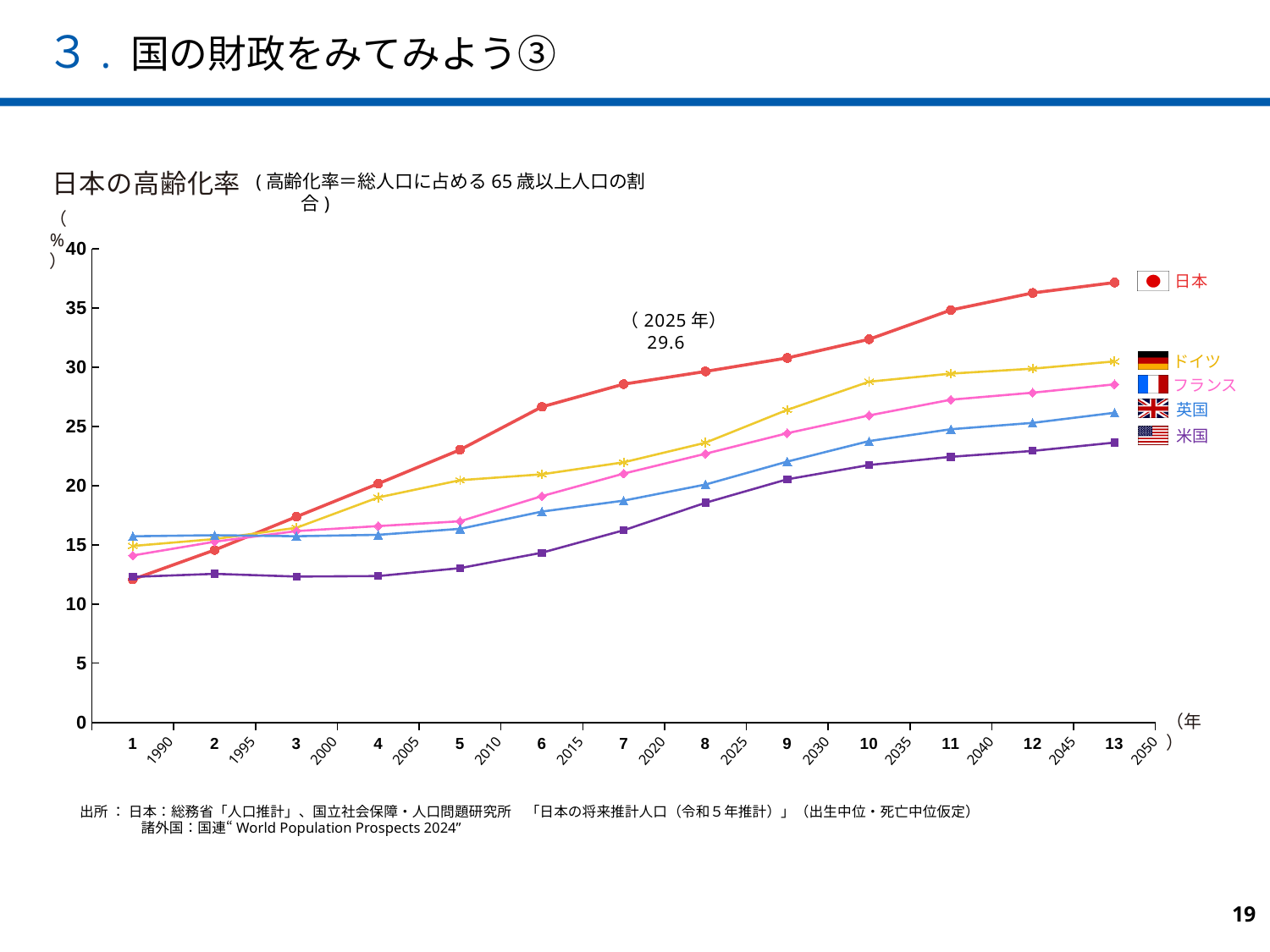
Which series are listed in the legend? 日本, ドイツ, フランス, 英国, 米国 Is the value for 日本 in 2050 greater or less than 35? greater Is the value for 米国 in 2050 greater or less than 25? less Is the value for フランス in 2050 greater or less than 30? less What is the value labelled for 日本 in 2025? 29.6 Which is larger in 2050, the value for フランス or the value for 英国? フランス How many series does the legend list? 5 What kind of chart is shown on the slide? line chart Which series has the lowest value in 2050? 米国 Does the 日本 line rise or fall from 1990 to 2050? rise Which series has the highest value in 2050? 日本